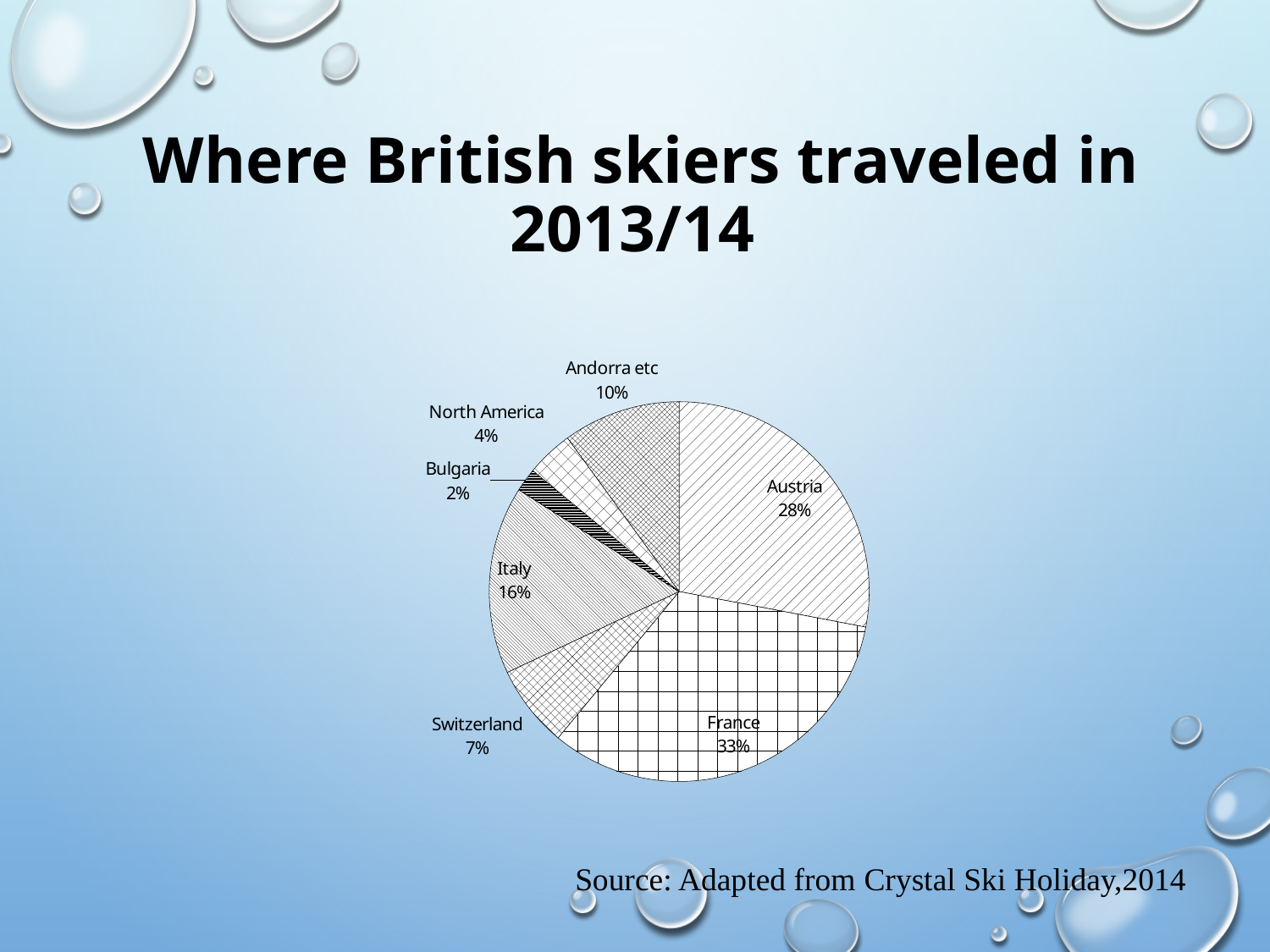
What percentage is shown for Italy? 16% What kind of chart is shown on the slide? pie chart What is the difference in percentage points between France and Austria? 5 Which has a larger share, Switzerland or North America? Switzerland How many destinations are shown in the pie chart? 7 What share of British skiers traveled to France in 2013/14? 33% What percentage is shown for Andorra etc? 10% What percentage is shown for Bulgaria? 2% Which destination has the smallest share of the pie? Bulgaria What is the title of the chart on the slide? Where British skiers traveled in 2013/14 What share of British skiers traveled to Austria? 28% Which destination has the largest share of the pie? France